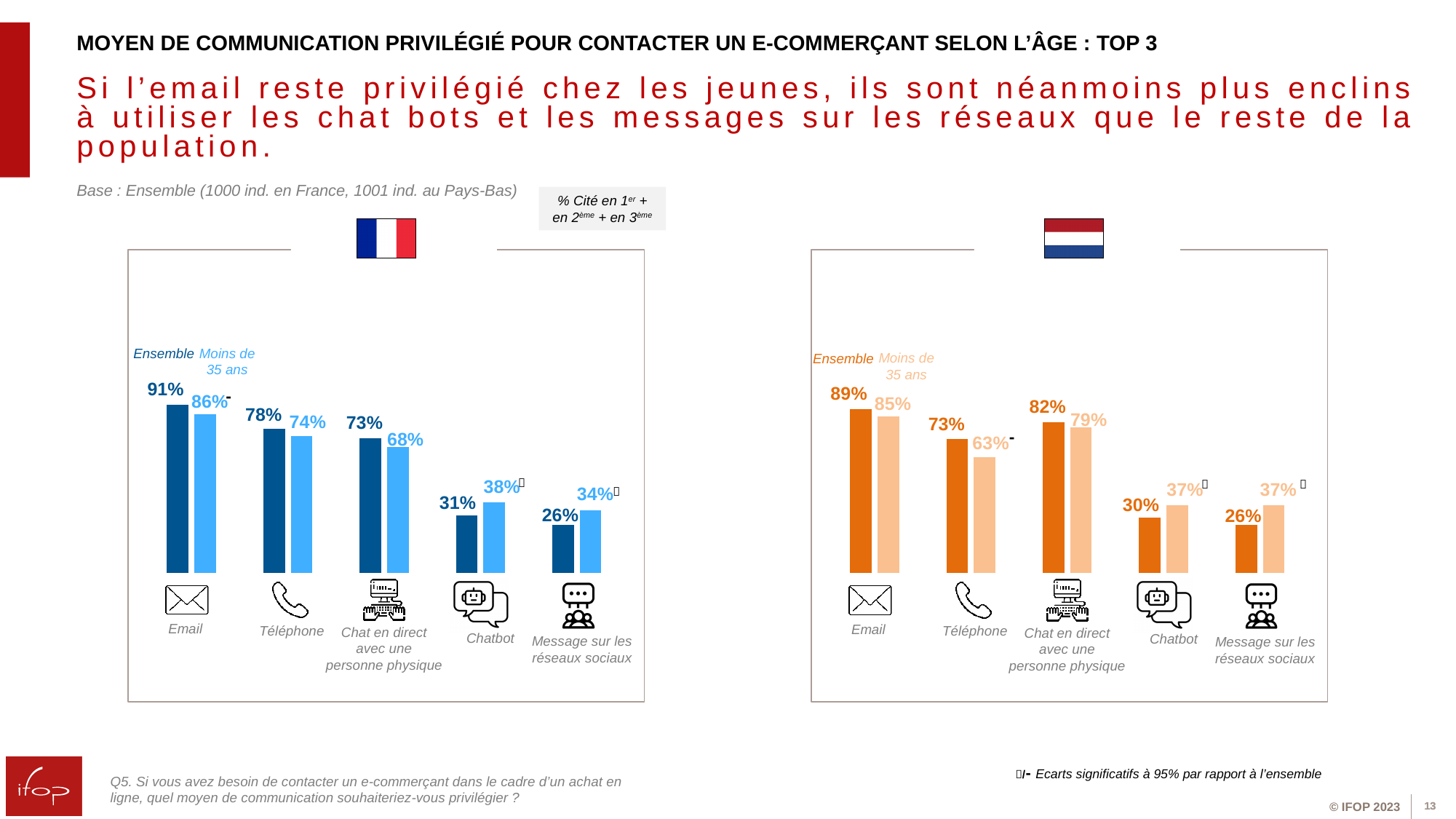
In the left chart (France), which category has the lowest Ensemble value? Message sur les réseaux sociaux In the right chart (Pays-Bas), what is the difference between the Ensemble and Moins de 35 ans values for Téléphone? 10 percentage points In the left chart (France), what is the Ensemble value for Email? 91% How many categories are shown in the right chart (Pays-Bas)? 5 How many series does the left chart (France) show? 2 In the left chart (France), what is the difference between the Ensemble and Moins de 35 ans values for Message sur les réseaux sociaux? 8 percentage points In the right chart (Pays-Bas), which category has the highest Ensemble value? Email In the left chart (France), what is the Moins de 35 ans value for Chatbot? 38% In the right chart (Pays-Bas), what is the Moins de 35 ans value for Téléphone? 63% In the left chart (France), which is larger for Chatbot: the Ensemble value or the Moins de 35 ans value? Moins de 35 ans In the right chart (Pays-Bas), what is the Ensemble value for Chat en direct avec une personne physique? 82% What type of chart is used on this slide? Bar chart